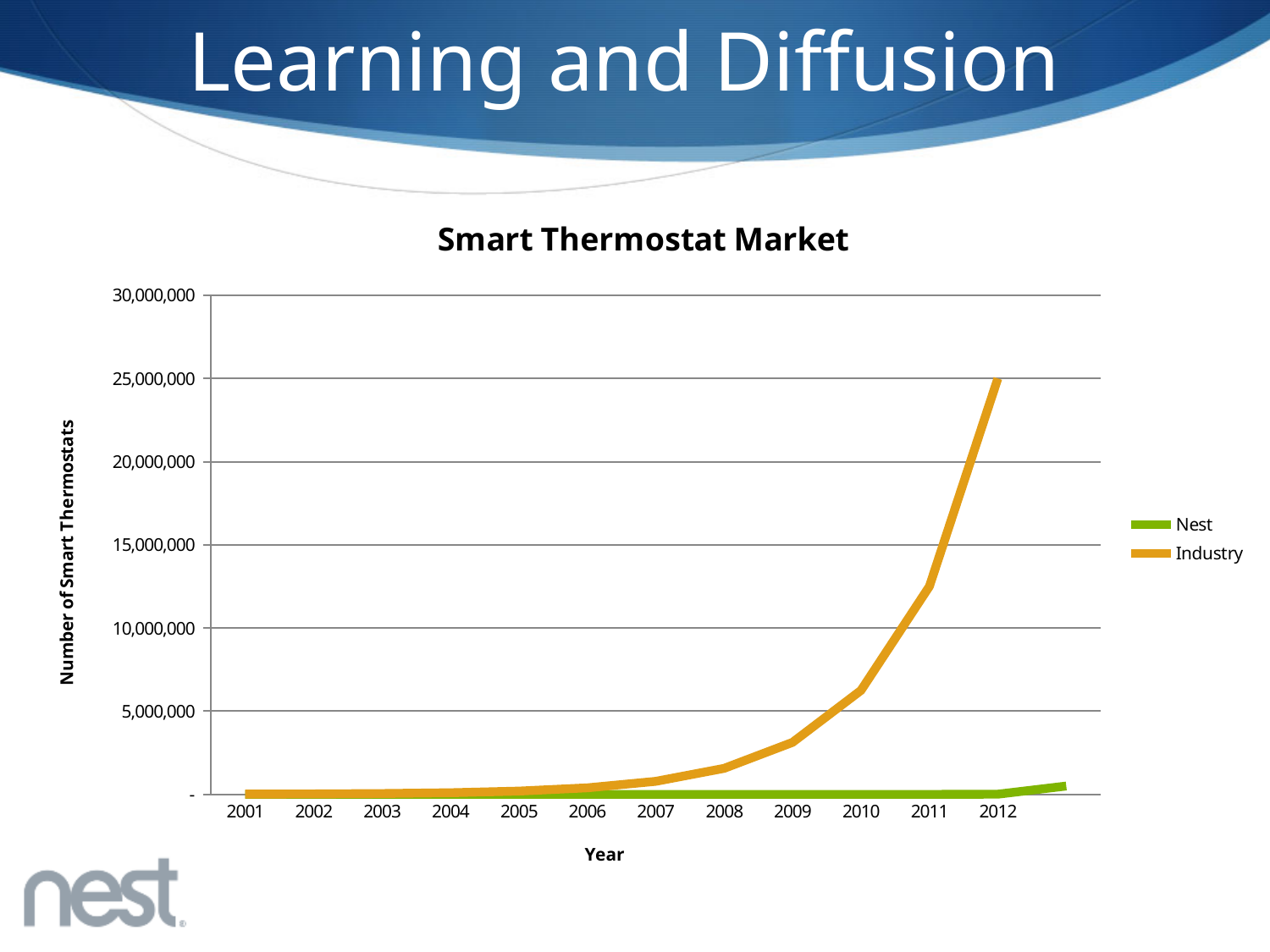
In 2012, which series has the larger value, Nest or Industry? Industry What are the two series named in the legend? Nest and Industry How many series does the legend list? 2 In which year is the Industry series at its highest? 2012 Is the Industry value for 2011 greater or less than 10,000,000? greater Is the Nest value for 2012 greater or less than 5,000,000? less Is the Industry value for 2009 greater or less than 5,000,000? less How many years are labelled on the x axis? 12 Does the Industry line rise or fall from 2001 to 2012? rise What is the title of the chart? Smart Thermostat Market What kind of chart is shown on the slide? line chart